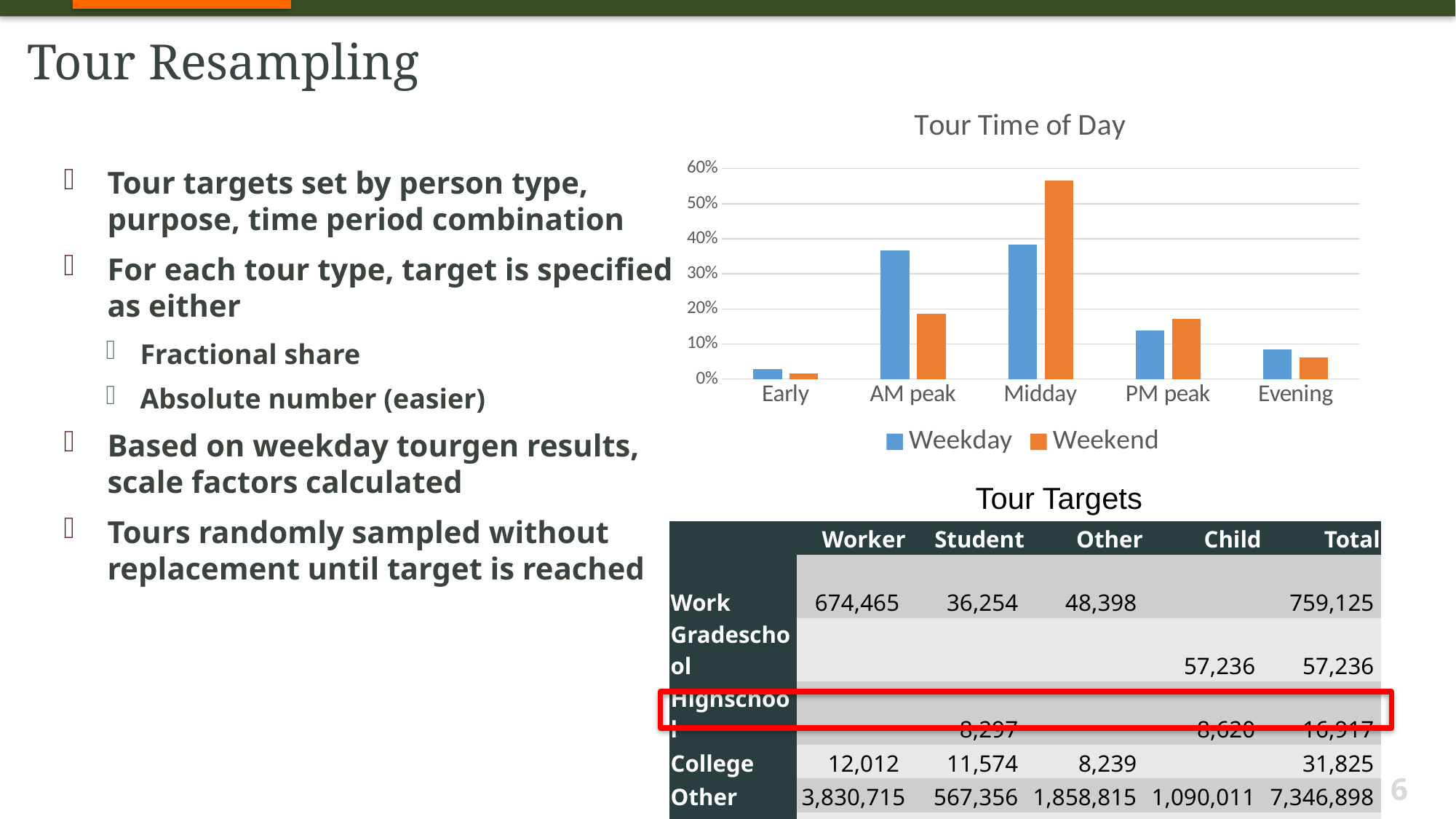
In the "Tour Time of Day" chart, which colour represents the Weekend series? orange In the "Tour Time of Day" chart, which time period has the lowest Weekend share? Early How many time-of-day categories are shown on the x axis of the "Tour Time of Day" chart? 5 In the "Tour Time of Day" chart, which time period has the lowest Weekday share? Early In the "Tour Time of Day" chart, which time period has the highest Weekend share? Midday How many series does the legend of the "Tour Time of Day" chart list? 2 In the "Tour Time of Day" chart, is the Weekend value for PM peak greater or less than 20%? less In the "Tour Time of Day" chart, is the Weekend value for Midday greater or less than 50%? greater In the "Tour Time of Day" chart, for Midday, which series has the larger value, Weekday or Weekend? Weekend What kind of chart is the "Tour Time of Day" chart? bar chart In the "Tour Time of Day" chart, for AM peak, which series has the larger value, Weekday or Weekend? Weekday In the "Tour Time of Day" chart, is the Weekday value for AM peak greater or less than 30%? greater